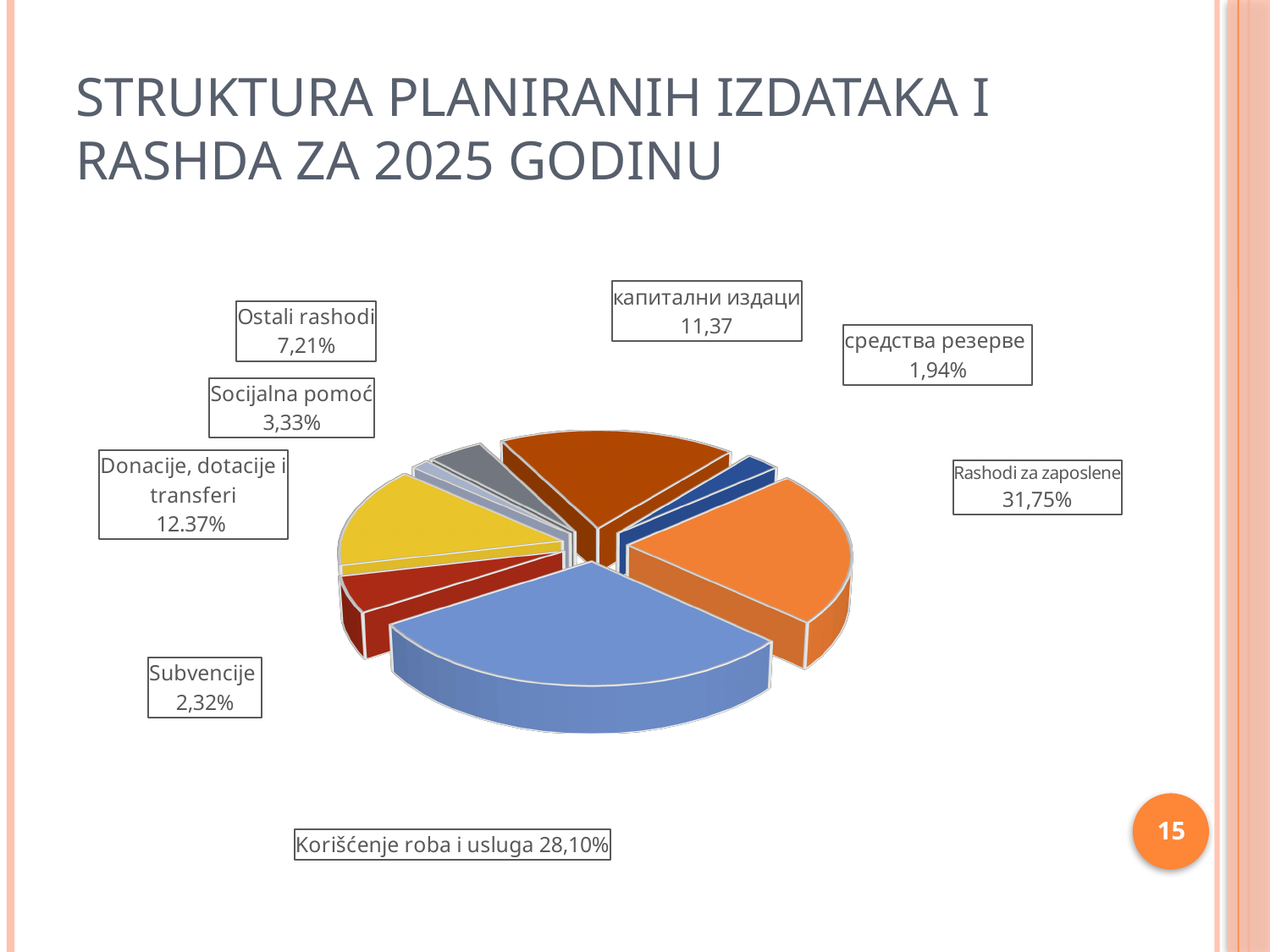
Which category has the largest share of the pie? Rashodi za zaposlene How many categories are shown in the pie chart? 8 What is the share for Korišćenje roba i usluga? 28,10% What value is shown for капитални издаци? 11,37 Which category has the smallest share of the pie? средства резерве What kind of chart is shown on the slide? pie chart What is the share for Rashodi za zaposlene? 31,75% What is the title of the slide containing the chart? STRUKTURA PLANIRANIH IZDATAKA I RASHDA ZA 2025 GODINU What is the difference between the shares of Rashodi za zaposlene and Korišćenje roba i usluga? 3,65% What is the share for Donacije, dotacije i transferi? 12.37% What is the share for Subvencije? 2,32% Which is larger, the share for Ostali rashodi or the share for Socijalna pomoć? Ostali rashodi